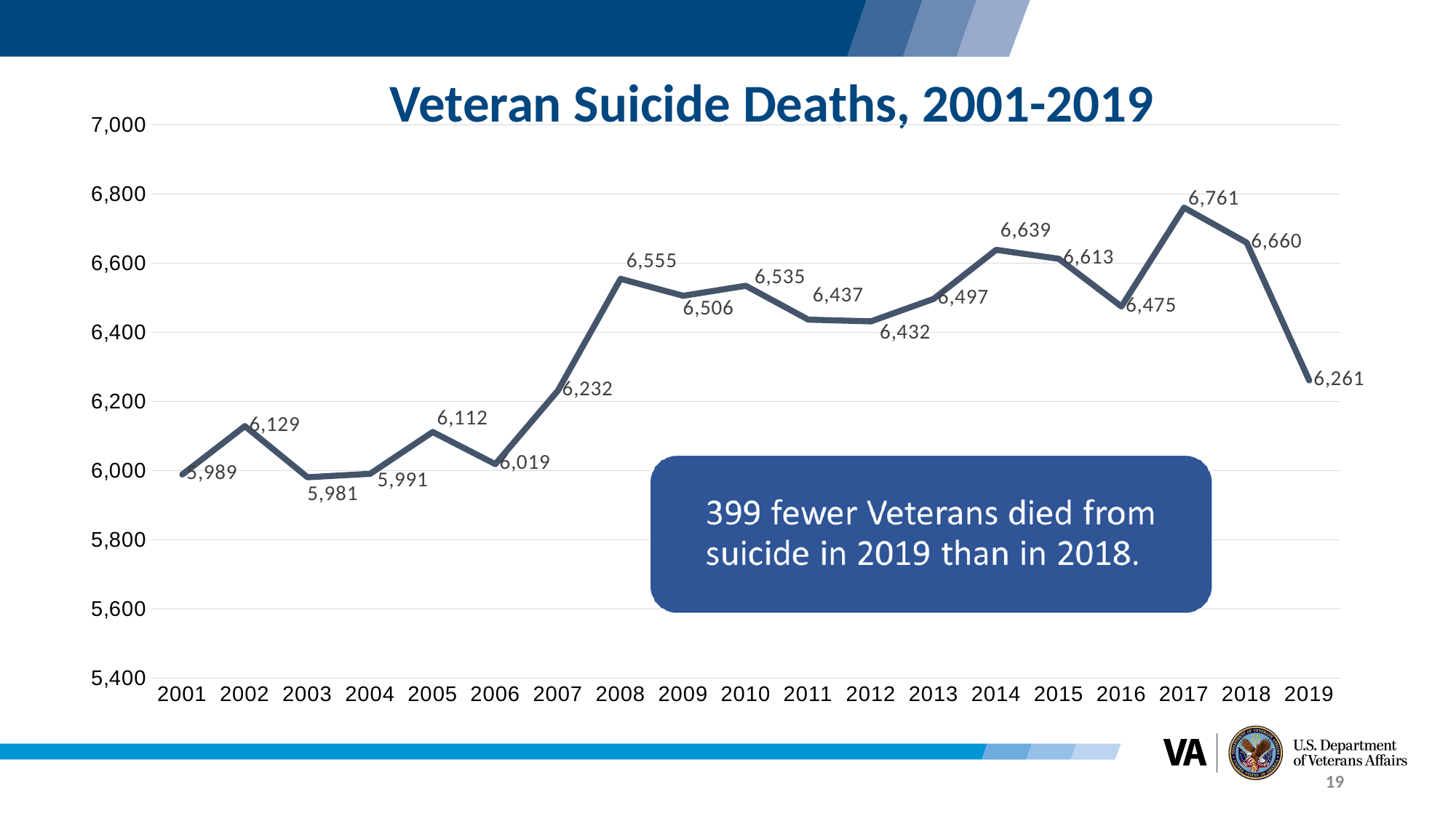
What is the title of the chart? Veteran Suicide Deaths, 2001-2019 Which year had more Veteran suicide deaths, 2014 or 2015? 2014 Is the value for 2010 greater or less than 6,400? greater What is the number of Veteran suicide deaths in 2017? 6,761 What is the number of Veteran suicide deaths in 2019? 6,261 How many years are plotted on the chart? 19 What is the number of Veteran suicide deaths in 2003? 5,981 What is the difference in Veteran suicide deaths between 2008 and 2007? 323 Which year has the highest number of Veteran suicide deaths? 2017 What kind of chart is shown on the slide? line chart What is the difference in Veteran suicide deaths between 2018 and 2019? 399 Which year has the lowest number of Veteran suicide deaths? 2003